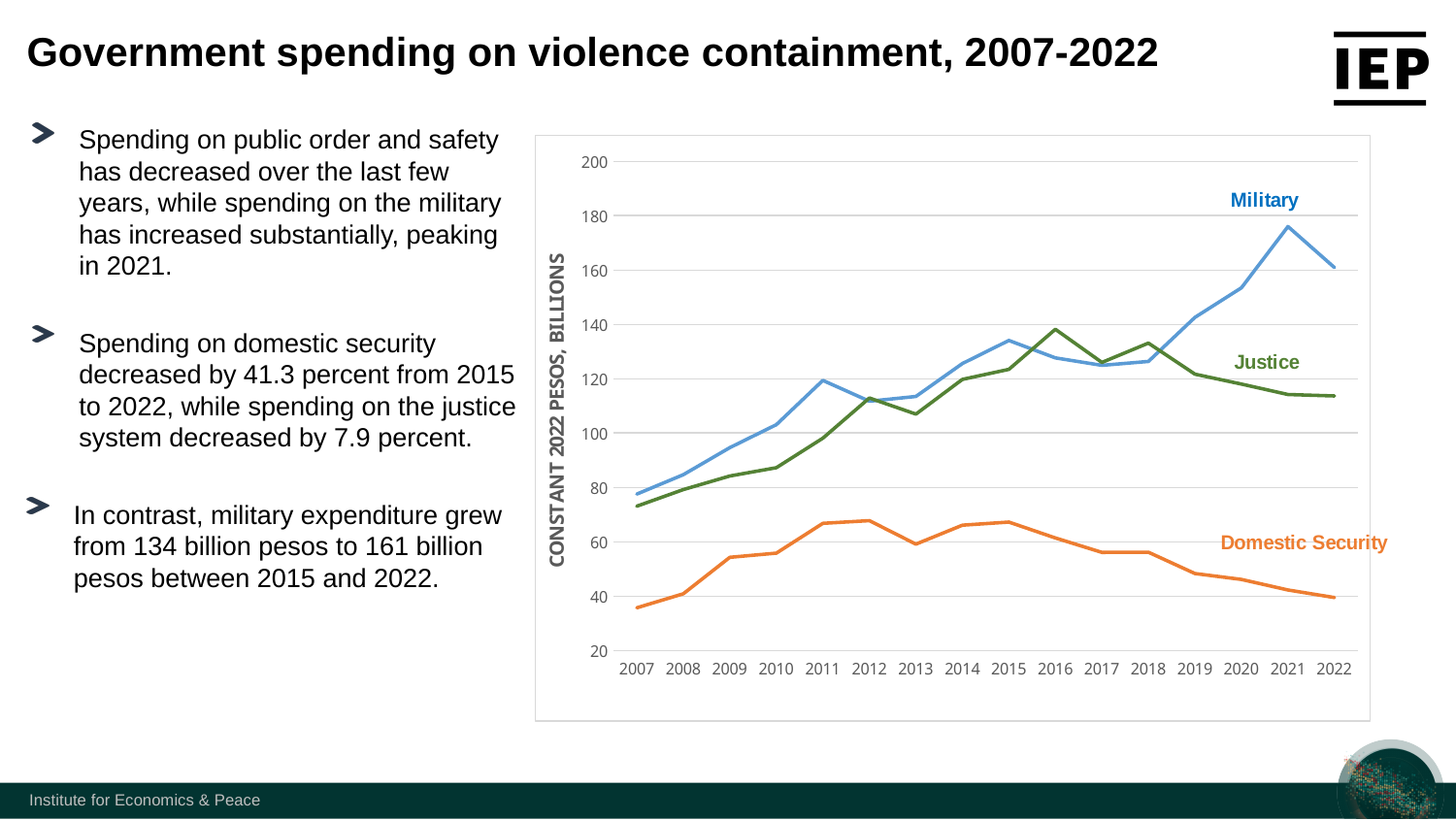
What is the label on the y axis of the chart? CONSTANT 2022 PESOS, BILLIONS Is the value for Domestic Security in 2022 greater or less than 60? less Does the Domestic Security series rise or fall from 2015 to 2022? Fall How many years are shown along the x axis of the chart? 16 In 2016, which is higher, Military or Justice? Justice In which year does the Military series reach its peak? 2021 Is the value for Justice in 2016 greater or less than 120? greater Which series has the highest value in 2021? Military How many series are plotted on the chart? 3 Is the value for Military in 2021 greater or less than 160? greater Which series has the lowest values across the whole period? Domestic Security What kind of chart is shown on the slide? Line chart